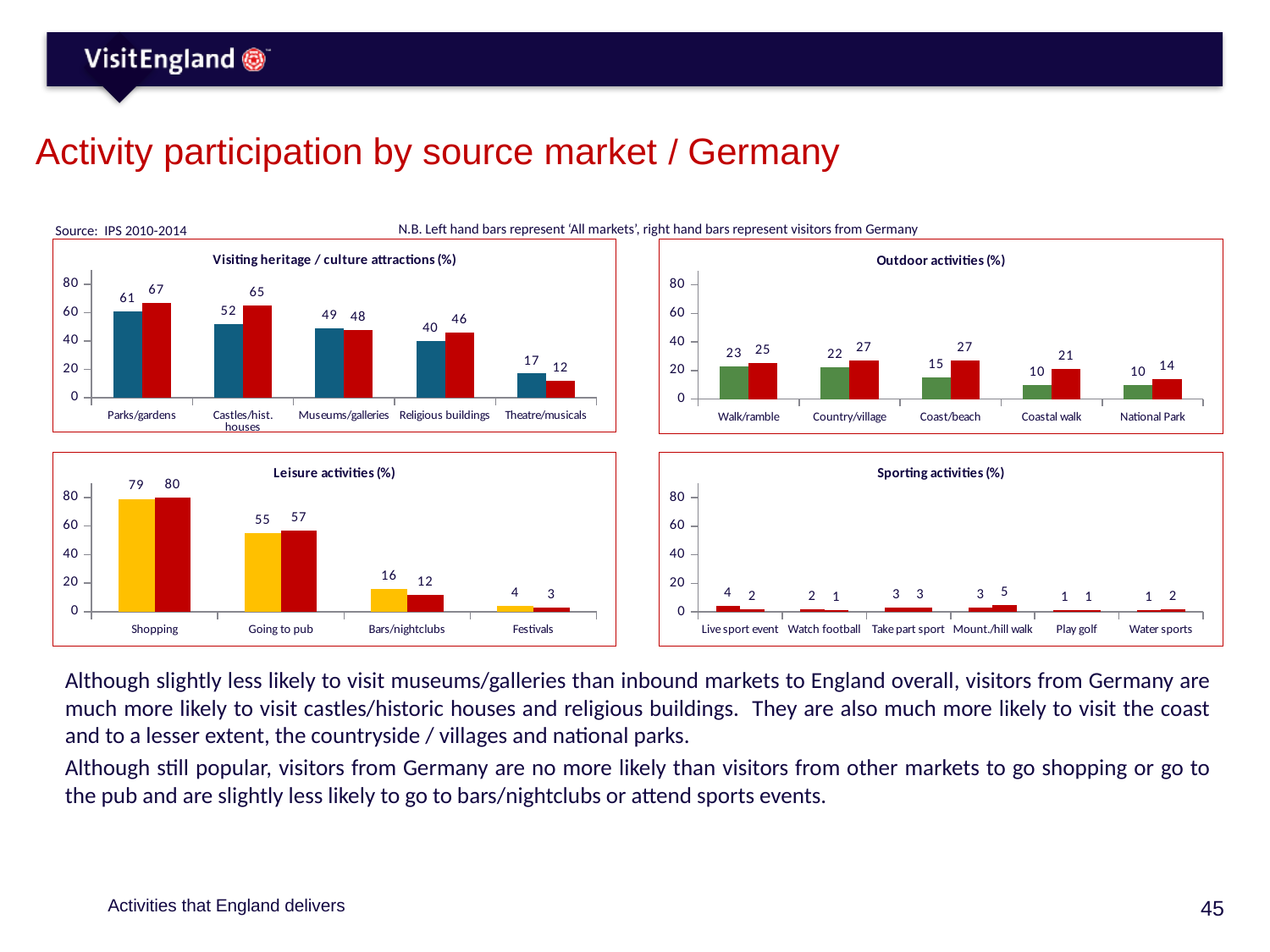
In the 'Leisure activities (%)' chart, which is larger for Bars/nightclubs: the 'All markets' value or the Germany value? All markets What type of chart is the 'Sporting activities (%)' chart? Bar chart In the 'Visiting heritage / culture attractions (%)' chart, which category has the highest value for visitors from Germany? Parks/gardens In the 'Leisure activities (%)' chart, what is the value for visitors from Germany for Going to pub? 57 In the 'Outdoor activities (%)' chart, how many activity categories are shown? 5 In the 'Sporting activities (%)' chart, what is the value for visitors from Germany for Mount./hill walk? 5 In the 'Visiting heritage / culture attractions (%)' chart, what is the 'All markets' value for Theatre/musicals? 17 In the 'Visiting heritage / culture attractions (%)' chart, what is the value for visitors from Germany for Castles/hist. houses? 65 In the 'Outdoor activities (%)' chart, what is the difference between the Germany value and the 'All markets' value for Coast/beach? 12 In the 'Leisure activities (%)' chart, is the 'All markets' value for Shopping greater or less than 60? greater In the 'Sporting activities (%)' chart, how many activity categories are shown? 6 In the 'Outdoor activities (%)' chart, which category has the lowest 'All markets' value? Coastal walk and National Park (both 10)